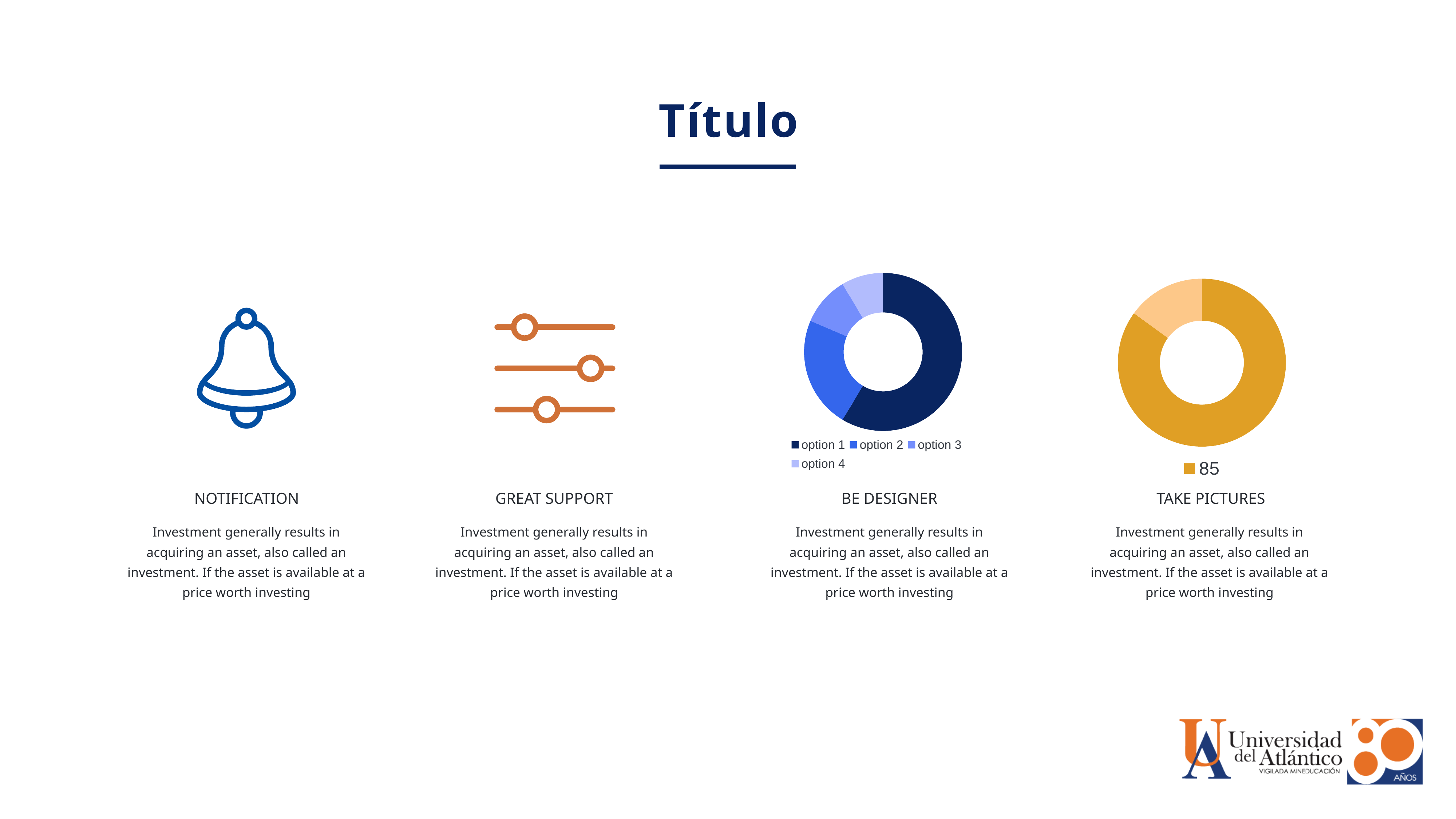
In the chart under TAKE PICTURES, what is the legend entry text? 85 In the chart under BE DESIGNER, how many categories does the legend list? 4 In the chart under BE DESIGNER, which slice is larger, option 1 or option 2? option 1 In the chart under TAKE PICTURES, how many entries does the legend list? 1 What kind of chart is shown under the heading BE DESIGNER? doughnut chart What kind of chart is shown under the heading TAKE PICTURES? doughnut chart In the chart under BE DESIGNER, does option 1 take up more or less than half of the doughnut? more In the chart under BE DESIGNER, which category has the smallest slice? option 4 In the chart under BE DESIGNER, what colour is the slice for option 1? dark navy blue In the chart under BE DESIGNER, which category has the largest slice? option 1 In the chart under TAKE PICTURES, which slice is larger, the dark gold slice or the light orange slice? the dark gold slice In the chart under BE DESIGNER, which slice is larger, option 2 or option 3? option 2